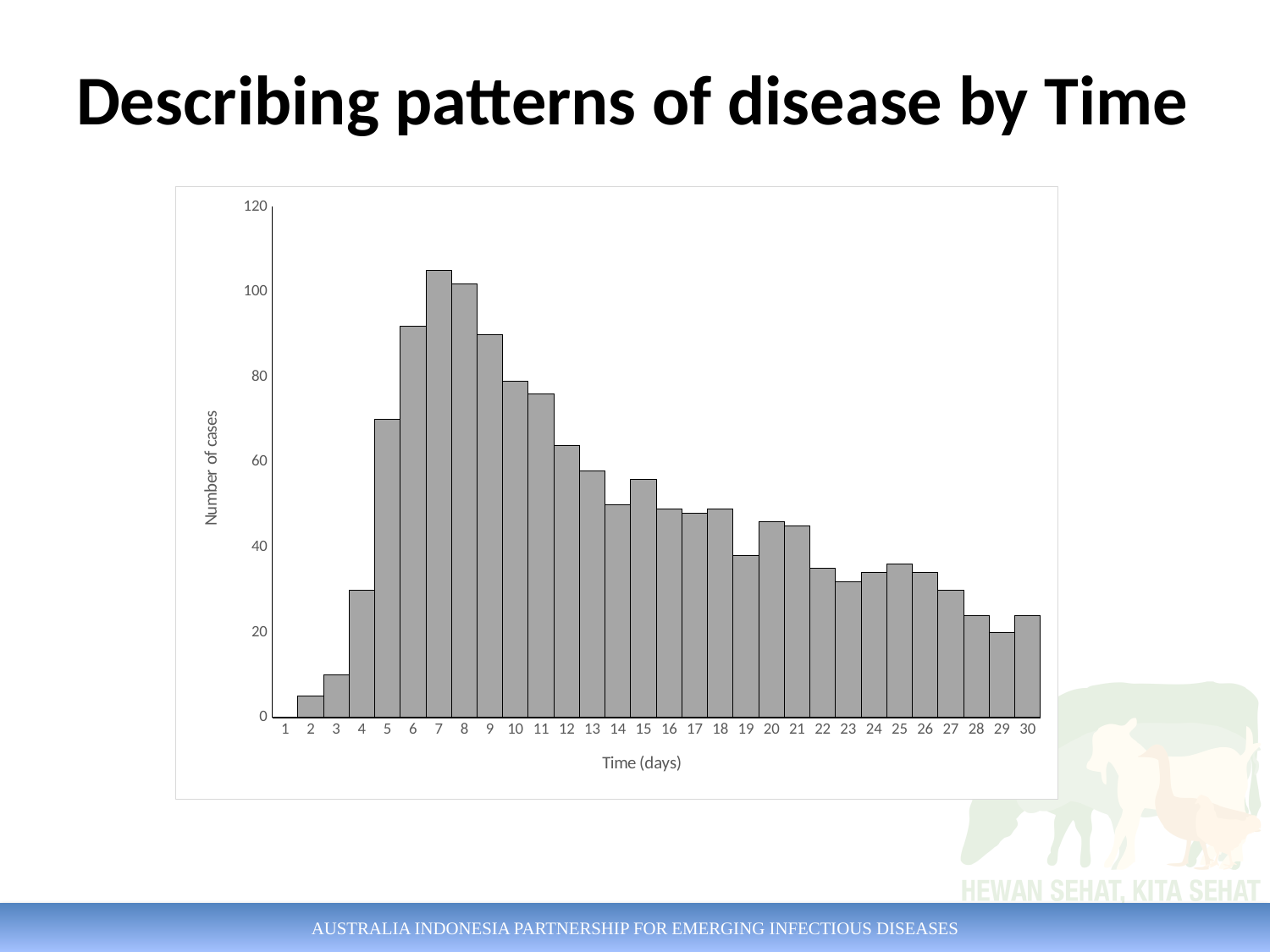
Is the number of cases on day 25 greater or less than 40? less What kind of chart is shown on the slide? bar chart Which has more cases, day 6 or day 10? day 6 Which has more cases, day 19 or day 20? day 20 Is the number of cases on day 29 greater or less than 40? less What is the label of the y axis? Number of cases Do the number of cases generally rise or fall from day 7 to day 30? fall Is the number of cases on day 7 greater or less than 100? greater Which day has the highest number of cases? 7 How many days are shown on the x axis of the chart? 30